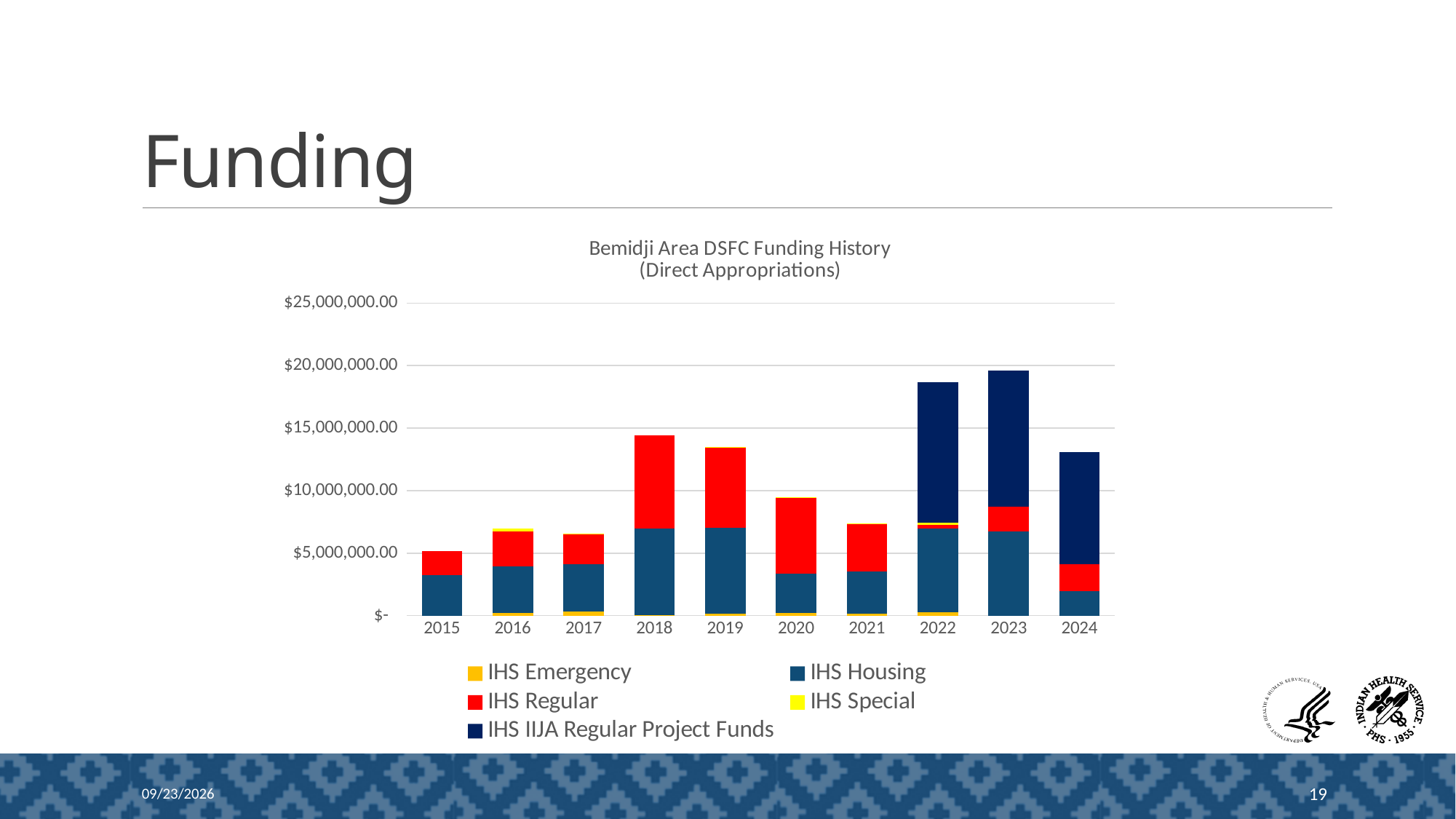
Is the total funding for 2018 greater or less than $10,000,000.00? greater Is the total funding for 2022 greater or less than $15,000,000.00? greater Do the total funding bars rise or fall from 2019 to 2021? fall Which year has the highest total funding bar? 2023 Is the total funding for 2024 greater or less than $15,000,000.00? less Which year has the lowest total funding bar? 2015 How many years are shown on the x axis? 10 Which year has a larger total funding bar, 2022 or 2024? 2022 What is the title of the chart? Bemidji Area DSFC Funding History (Direct Appropriations) What type of chart is shown on the slide? Stacked bar chart How many series does the legend list? 5 Which series is shown in dark navy at the top of the 2022, 2023 and 2024 bars? IHS IIJA Regular Project Funds